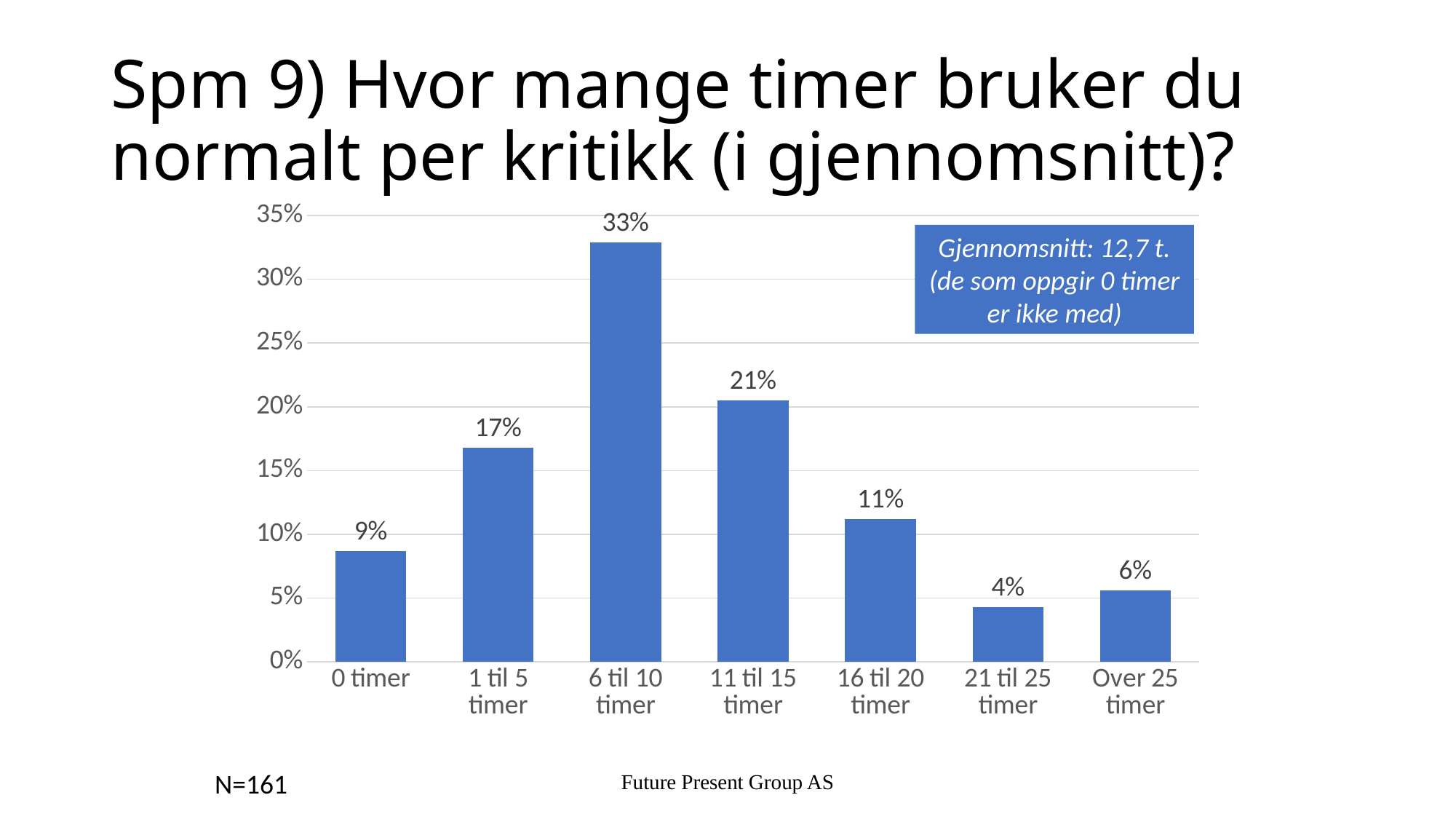
Is the value for "11 til 15 timer" greater or less than 20%? greater What is the difference between the values for "6 til 10 timer" and "11 til 15 timer"? 12% What average (gjennomsnitt) is stated in the text box on the chart? 12,7 t. What percentage of respondents answered "6 til 10 timer"? 33% Which category has the highest value? 6 til 10 timer Do the values rise or fall from "6 til 10 timer" to "21 til 25 timer"? Fall What percentage is shown for "Over 25 timer"? 6% Which category has the lowest value? 21 til 25 timer How many categories are shown on the x axis? 7 What kind of chart is shown on the slide? Bar chart Which is larger, the value for "1 til 5 timer" or the value for "16 til 20 timer"? 1 til 5 timer What is the value shown for "0 timer"? 9%